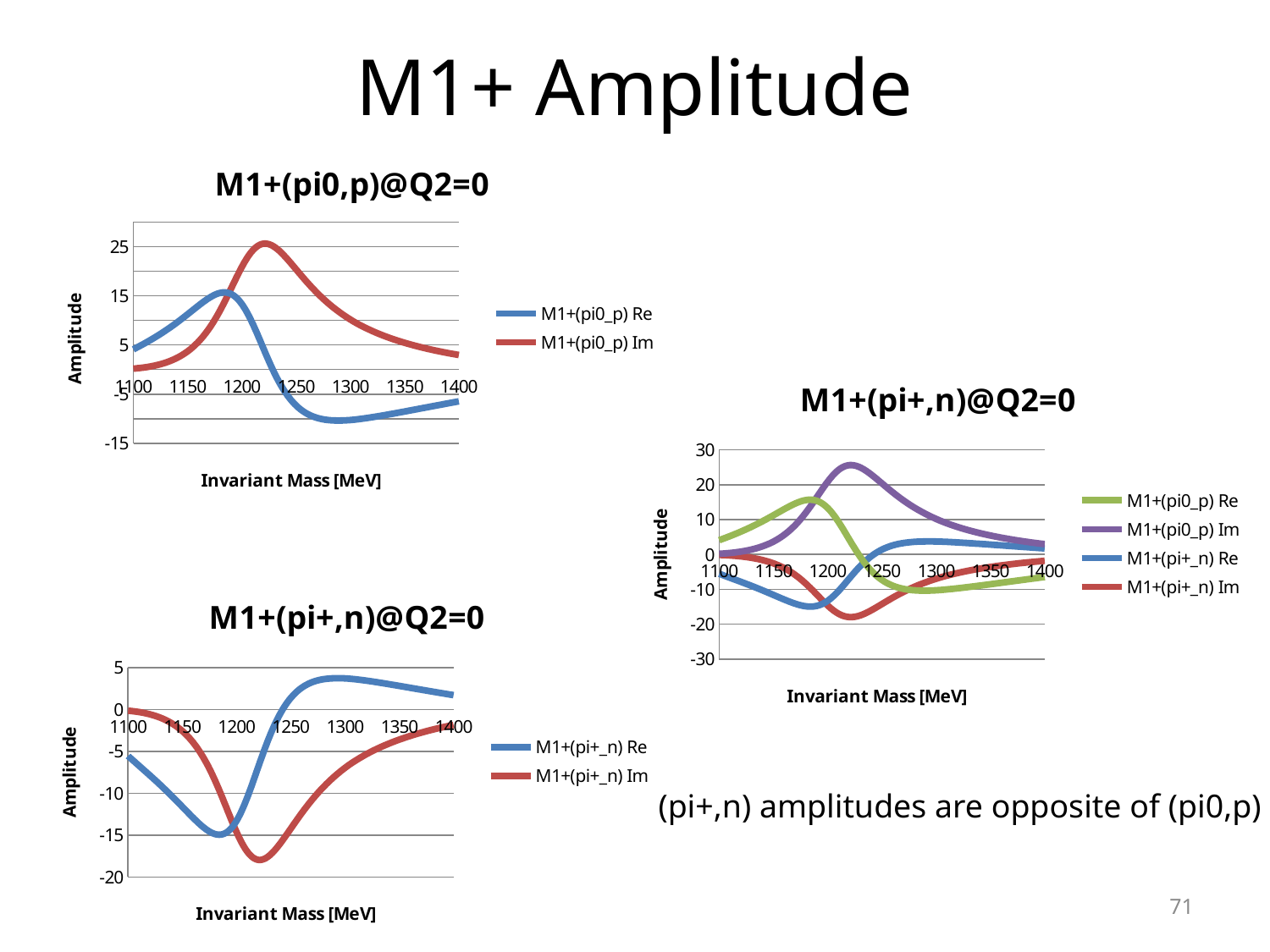
In the bottom-left chart (M1+(pi+,n)@Q2=0), is the minimum value of M1+(pi+_n) Im greater or less than -15? less In the top-left chart (M1+(pi0,p)@Q2=0), is the value of M1+(pi0_p) Im at 1300 greater or less than 5? greater What is the x-axis title of the top-left chart (M1+(pi0,p)@Q2=0)? Invariant Mass [MeV] In the top-left chart (M1+(pi0,p)@Q2=0), which series has the larger value at 1300: M1+(pi0_p) Re or M1+(pi0_p) Im? M1+(pi0_p) Im In the top-left chart (M1+(pi0,p)@Q2=0), does M1+(pi0_p) Im rise or fall between 1250 and 1400? fall What kind of chart is the top-left chart titled M1+(pi0,p)@Q2=0? line chart How many series does the legend of the bottom-left chart (M1+(pi+,n)@Q2=0) list? 2 How many series does the legend of the top-left chart (M1+(pi0,p)@Q2=0) list? 2 How many series does the legend of the right-hand chart (M1+(pi+,n)@Q2=0) list? 4 In the bottom-left chart (M1+(pi+,n)@Q2=0), does M1+(pi+_n) Re rise or fall between 1100 and 1200? fall In the bottom-left chart (M1+(pi+,n)@Q2=0), is the value of M1+(pi+_n) Re at 1300 greater or less than 0? greater